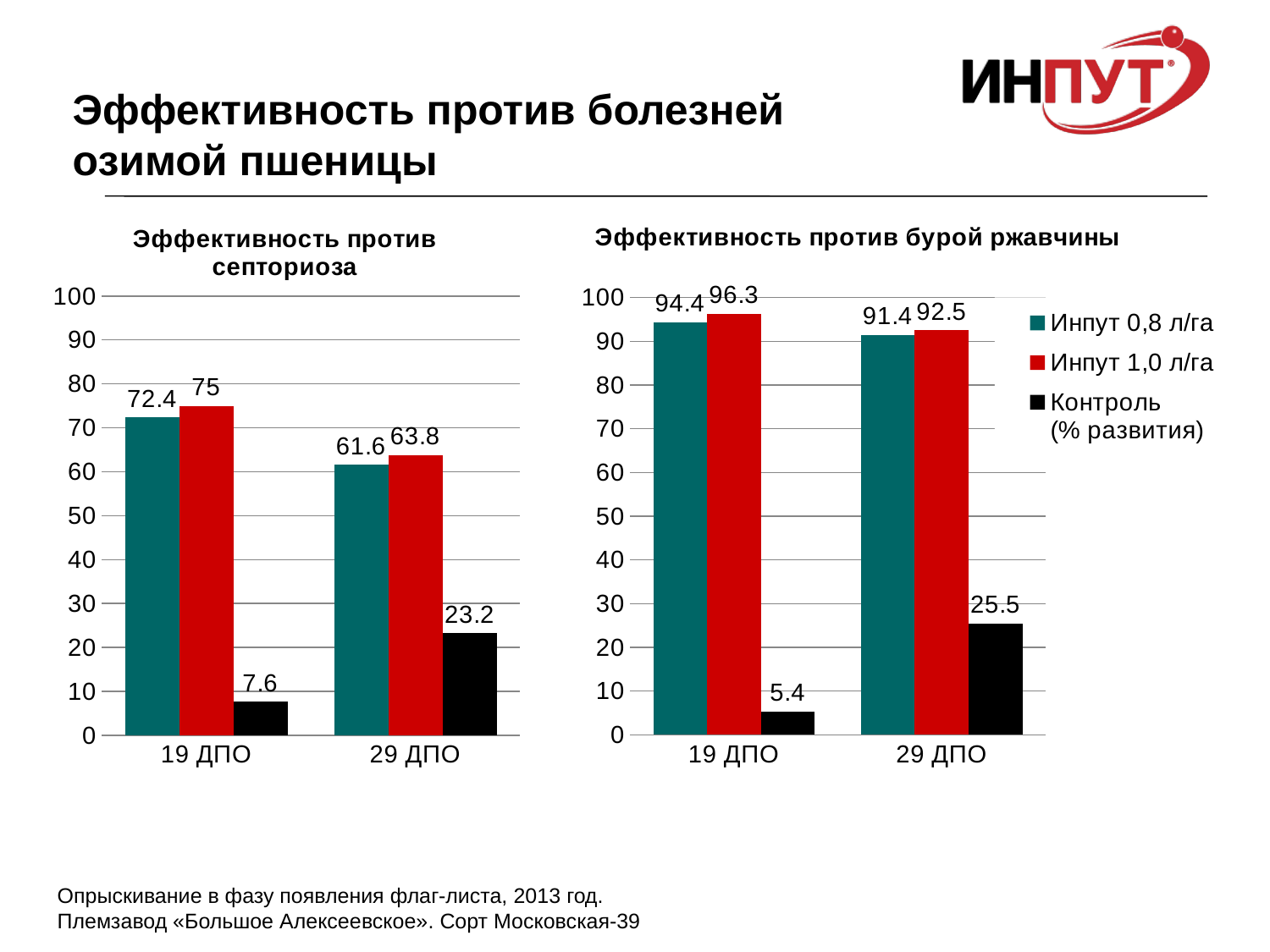
In the chart 'Эффективность против бурой ржавчины', which series has the highest value at 19 ДПО? Инпут 1,0 л/га In the chart 'Эффективность против бурой ржавчины', what is the value for Контроль (% развития) at 29 ДПО? 25.5 In the chart 'Эффективность против септориоза', which series has the lowest value at 29 ДПО? Контроль (% развития) In the chart 'Эффективность против септориоза', is the value for Инпут 0,8 л/га higher at 19 ДПО or at 29 ДПО? 19 ДПО In the chart 'Эффективность против бурой ржавчины', what is the difference between Инпут 1,0 л/га and Инпут 0,8 л/га at 19 ДПО? 1.9 How many categories are shown on the x axis of the chart 'Эффективность против септориоза'? 2 In the chart 'Эффективность против септориоза', what is the value for Инпут 0,8 л/га at 19 ДПО? 72.4 In the chart 'Эффективность против септориоза', what is the difference between the Контроль values at 29 ДПО and 19 ДПО? 15.6 How many series does the legend of the chart 'Эффективность против бурой ржавчины' list? 3 In the chart 'Эффективность против септориоза', what is the value for Инпут 1,0 л/га at 29 ДПО? 63.8 What type of chart is 'Эффективность против бурой ржавчины'? Bar chart In the chart 'Эффективность против бурой ржавчины', is the value for Инпут 0,8 л/га at 29 ДПО greater or less than 90? greater